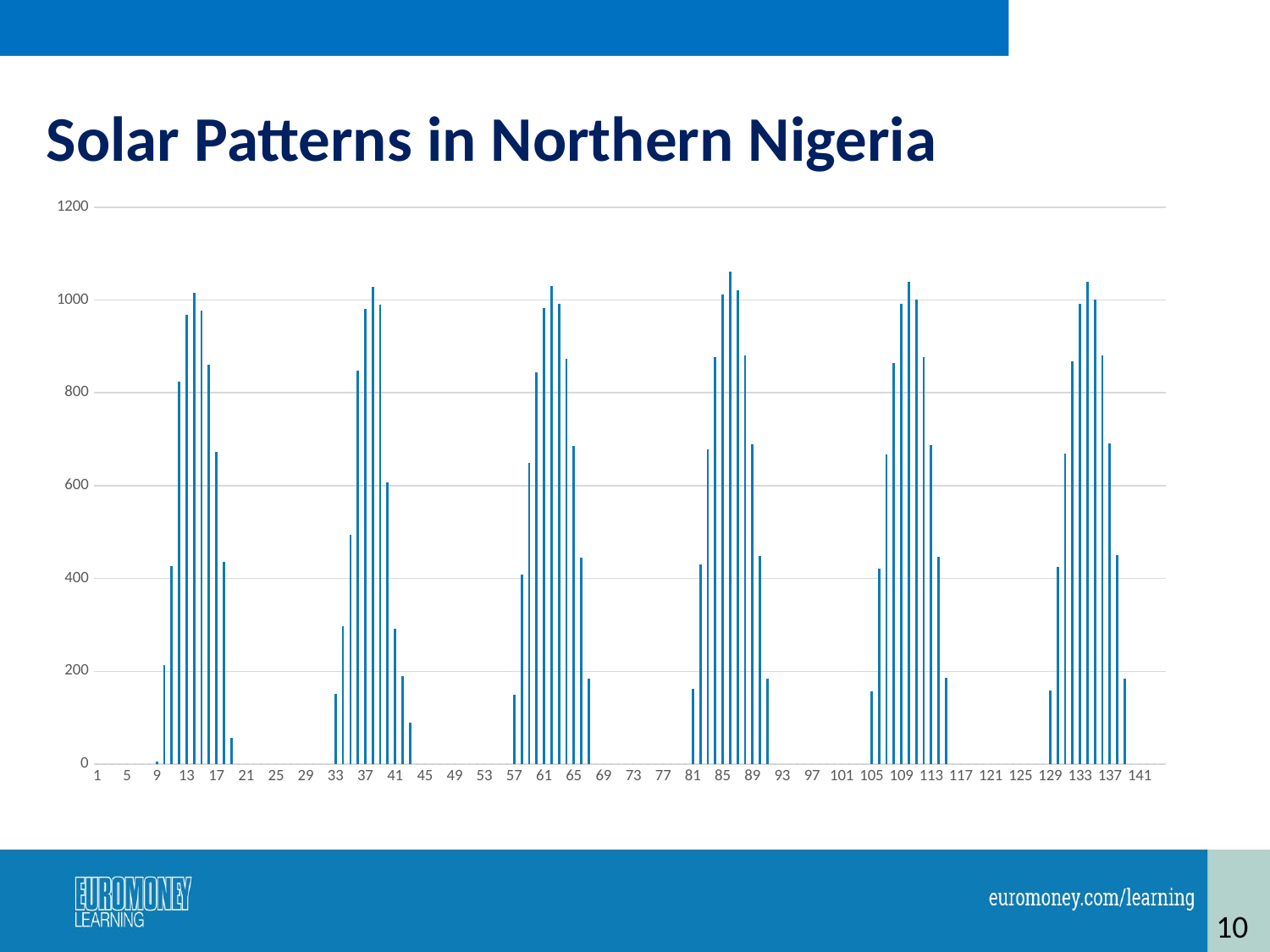
Is the value at x = 13 greater or less than 800? greater How many separate clusters of bars appear across the x axis? 6 What is the highest value shown on the y axis? 1200 What colour are the bars in the chart? blue Is the value at x = 85 greater or less than 800? greater Is the value at x = 37 greater or less than 800? greater What kind of chart is shown on the slide? bar chart What is the title of the chart? Solar Patterns in Northern Nigeria